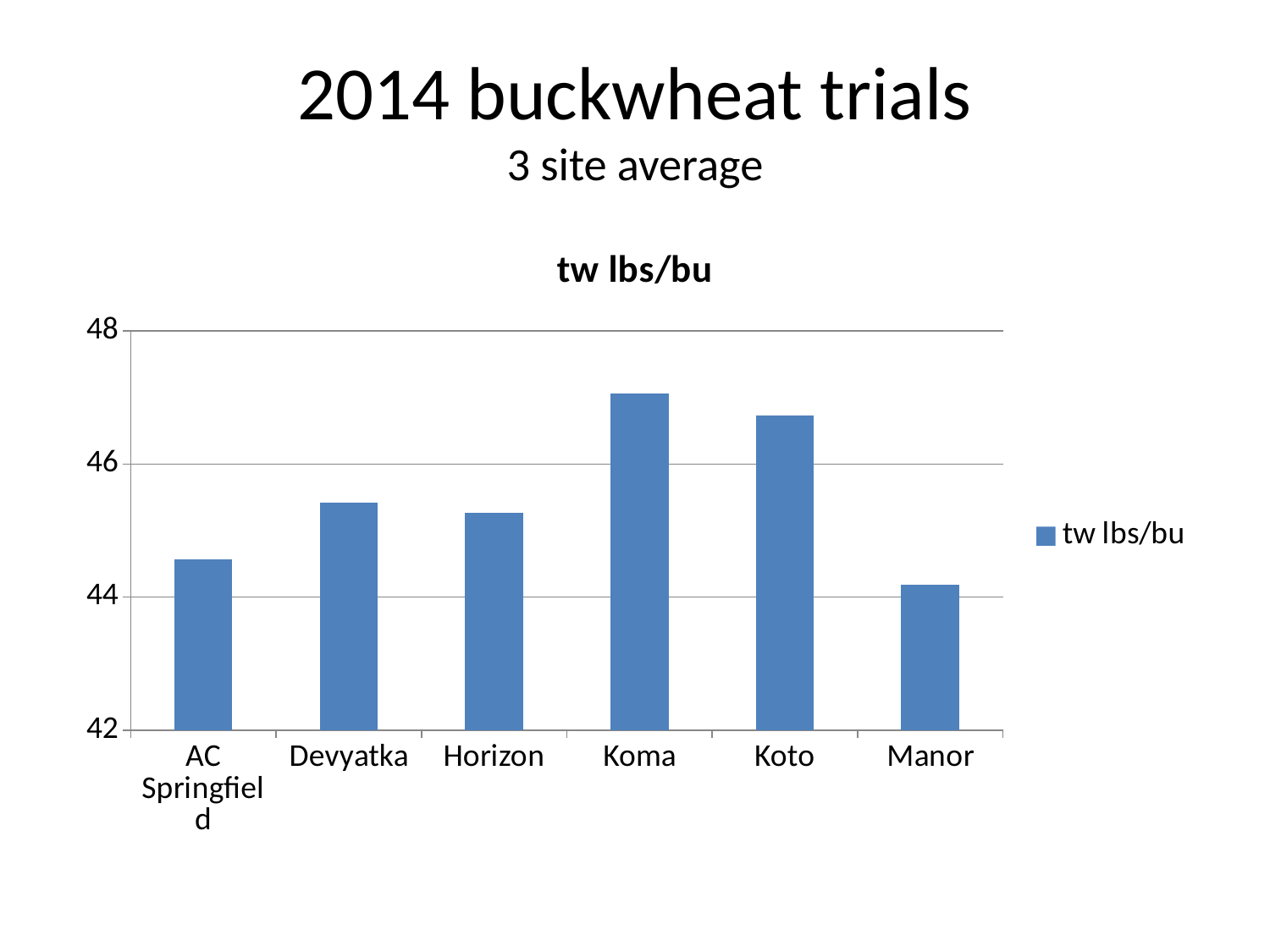
Is the value for Koma greater or less than 46? greater Is the value for AC Springfield greater or less than 44? greater What is the title of the chart? tw lbs/bu Which variety has the lowest test weight (tw lbs/bu)? Manor How many varieties (categories) are plotted in the chart? 6 Which is larger, the value for Manor or the value for Devyatka? Devyatka Is the value for Manor greater or less than 46? less Which variety has the highest test weight (tw lbs/bu)? Koma Which is larger, the value for Koto or the value for AC Springfield? Koto What kind of chart is shown on the slide? bar chart How many series does the legend list? 1